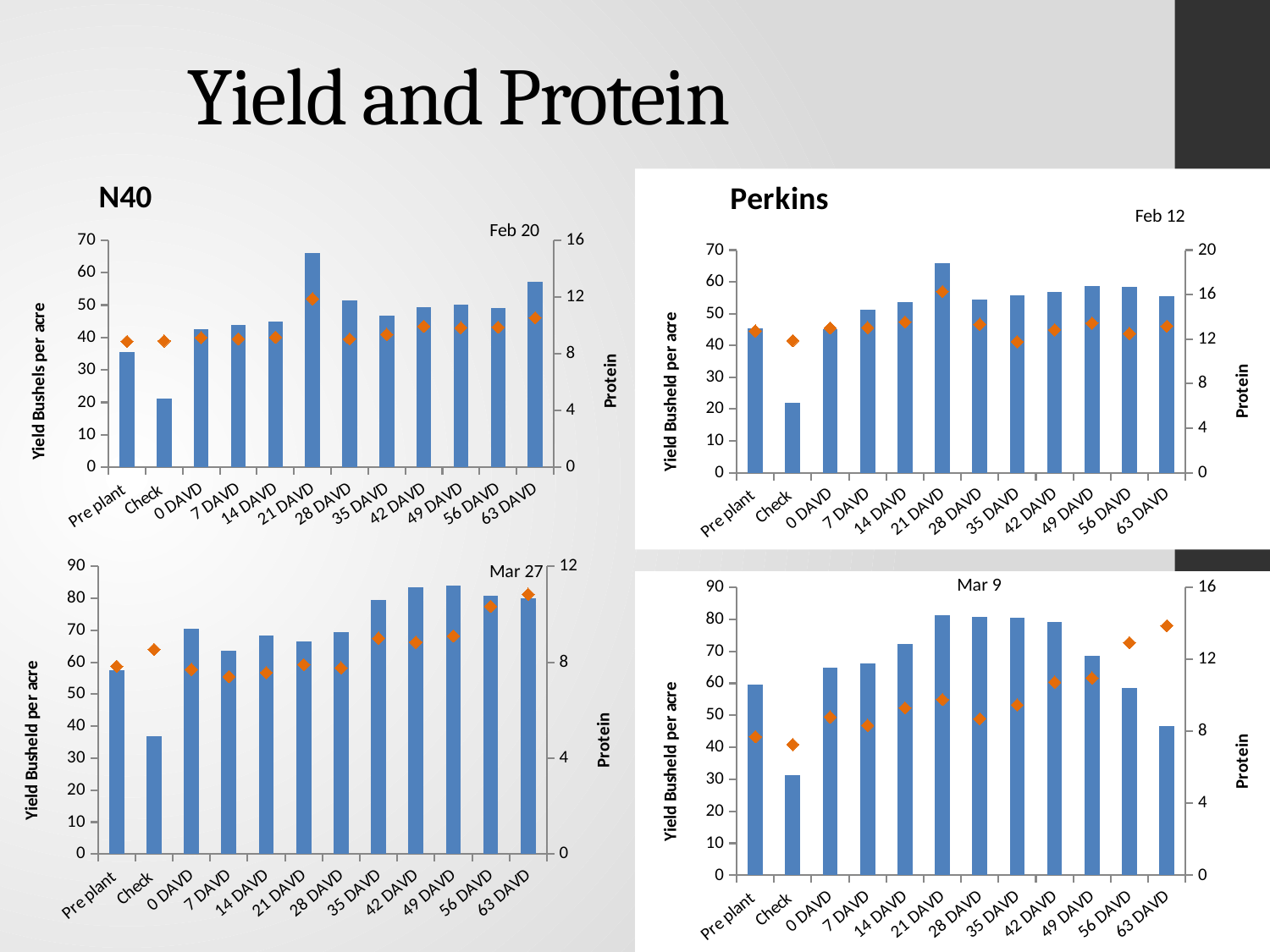
In the N40 Mar 27 chart, which treatment has the lowest yield bar? Check In the Perkins Mar 9 chart, which treatment has the lowest yield bar? Check In the N40 Feb 20 chart, which treatment has the lowest yield bar? Check In the Perkins Feb 12 chart, which treatment has the highest yield bar? 21 DAVD In the N40 Feb 20 chart, which treatment has the highest yield bar? 21 DAVD How many treatment categories are shown on the x axis of the N40 Feb 20 chart? 12 In the Perkins Mar 9 chart, which treatment has the highest protein marker? 63 DAVD In the Perkins Mar 9 chart, is the yield for 63 DAVD greater or less than 50? less In the Perkins Mar 9 chart, which has the larger yield bar, 21 DAVD or 63 DAVD? 21 DAVD In the Perkins Feb 12 chart, is the yield for 21 DAVD greater or less than 60? greater In the N40 Feb 20 chart, is the yield for Check greater or less than 30? less